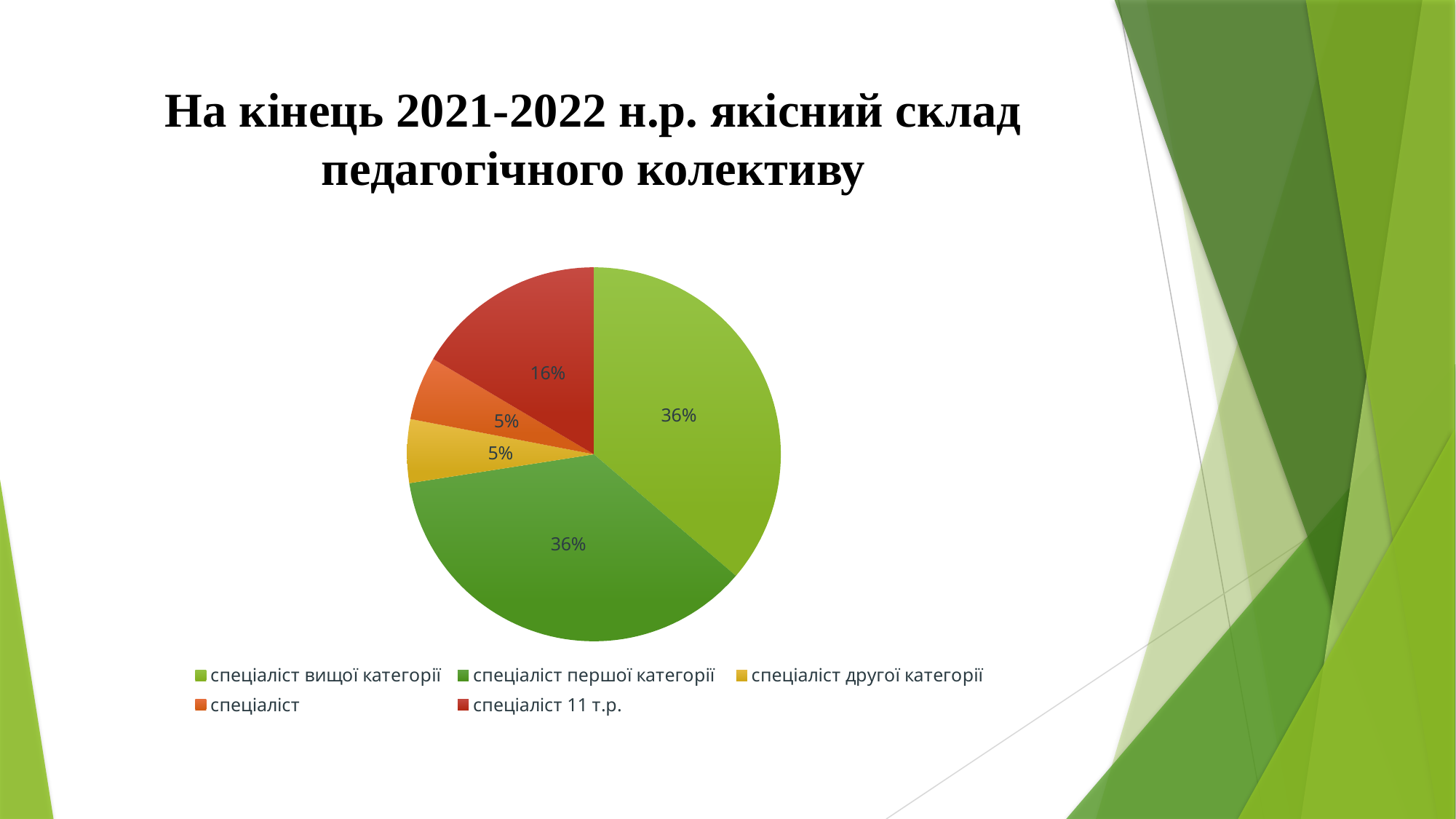
What share of the pie does спеціаліст 11 т.р. hold? 16% Which is larger, the share for спеціаліст вищої категорії or the share for спеціаліст 11 т.р.? спеціаліст вищої категорії What share of the pie does спеціаліст першої категорії hold? 36% What kind of chart is shown on the slide? Pie chart What share of the pie does спеціаліст вищої категорії hold? 36% What share of the pie does спеціаліст другої категорії hold? 5% Which is larger, the share for спеціаліст 11 т.р. or the share for спеціаліст? спеціаліст 11 т.р. What is the difference between the share for спеціаліст першої категорії and the share for спеціаліст 11 т.р.? 20% How many slices does the pie chart have? 5 What is the difference between the share for спеціаліст 11 т.р. and the share for спеціаліст другої категорії? 11% What is the title of the slide containing the chart? На кінець 2021-2022 н.р. якісний склад педагогічного колективу What share of the pie does спеціаліст hold? 5%